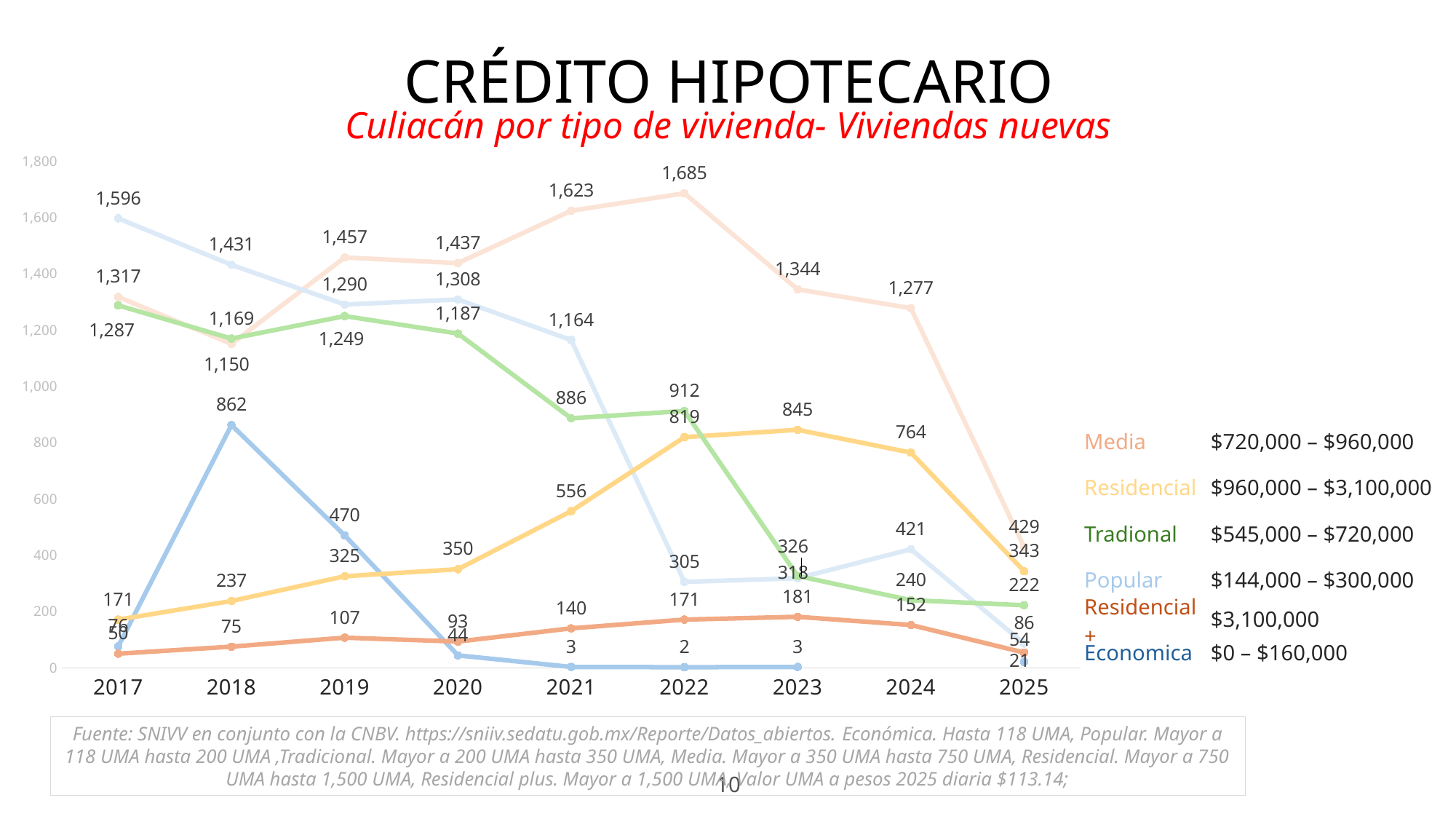
In which year does the Media series reach its highest value? 2022 How many series does the legend list? 6 What is the difference between the Popular value in 2017 and in 2025? 1,510 What is the value for Residencial in 2025? 343 What price range does the legend give for Media? $720,000 – $960,000 Does the Residencial series rise or fall from 2017 to 2023? rise What is the value for Economica in 2018? 862 What kind of chart is shown on the slide? line chart In 2023, which is larger: Residencial or Tradicional? Residencial How many years are shown on the x axis of the chart? 9 What is the value for Media in 2022? 1,685 In which year does the Popular series have its lowest value? 2025